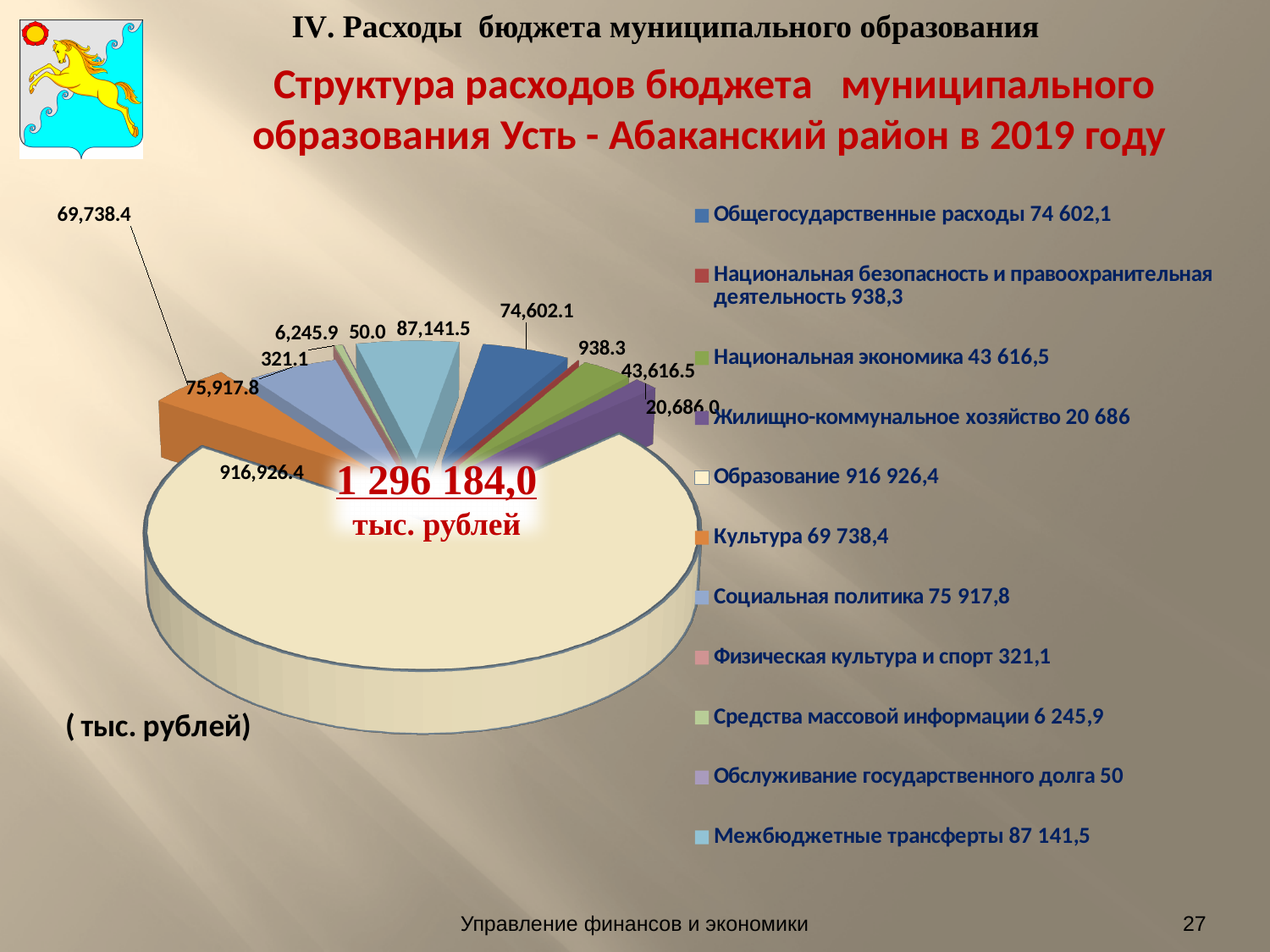
Which is larger, Национальная экономика or Жилищно-коммунальное хозяйство? Национальная экономика What kind of chart is shown on the slide? Pie chart Which category has the smallest value? Обслуживание государственного долга What is the difference between Социальная политика and Культура? 6,179.4 What is the value for Национальная экономика? 43,616.5 What is the value for Межбюджетные трансферты? 87,141.5 What is the value for Образование? 916,926.4 What is the value for Обслуживание государственного долга? 50.0 What is the difference between Межбюджетные трансферты and Общегосударственные расходы? 12,539.4 What total is printed in the centre of the pie chart? 1 296 184,0 тыс. рублей Which category has the largest value? Образование How many categories does the pie chart have? 11